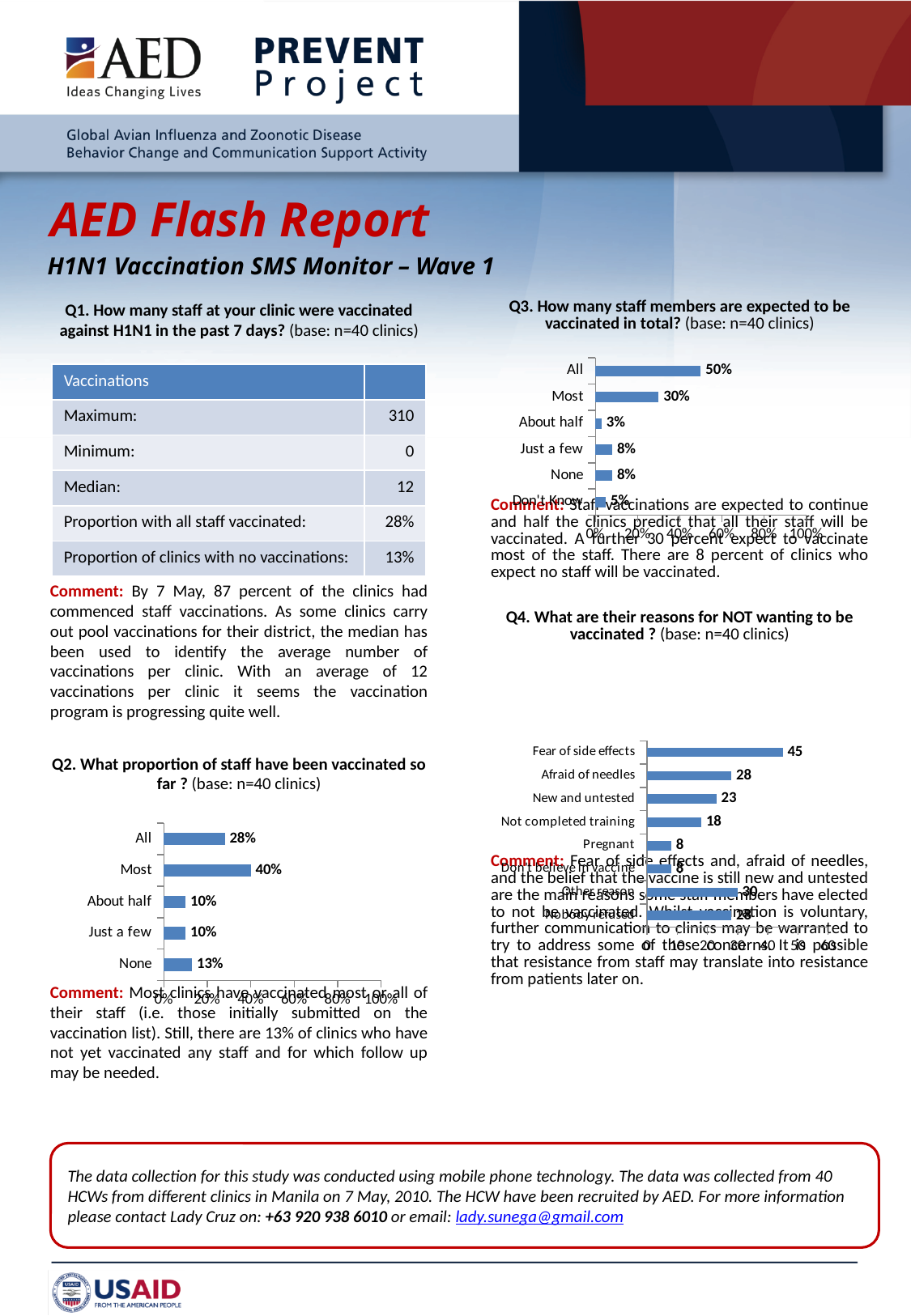
In the Q3 chart (How many staff members are expected to be vaccinated in total?), what is the value for "All"? 50% In the Q4 chart (reasons for NOT wanting to be vaccinated), what is the difference between the values for "Afraid of needles" and "New and untested"? 5 In the Q3 chart (How many staff members are expected to be vaccinated in total?), which is larger, the value for "Most" or the value for "Just a few"? Most In the Q4 chart (reasons for NOT wanting to be vaccinated), what is the value for "Fear of side effects"? 45 In the Q4 chart (reasons for NOT wanting to be vaccinated), is the value for "Not completed training" greater or less than 20? less In the Q2 chart (What proportion of staff have been vaccinated so far?), what is the value for "Most"? 40% In the Q3 chart (How many staff members are expected to be vaccinated in total?), which category has the lowest value? About half In the Q3 chart (How many staff members are expected to be vaccinated in total?), what is the value for "Don't Know"? 5% In the Q2 chart (What proportion of staff have been vaccinated so far?), how many categories are shown? 5 What kind of chart is the Q4 chart (reasons for NOT wanting to be vaccinated)? Bar chart In the Q2 chart (What proportion of staff have been vaccinated so far?), what is the difference between the values for "Most" and "All"? 12% In the Q2 chart (What proportion of staff have been vaccinated so far?), which category has the highest value? Most